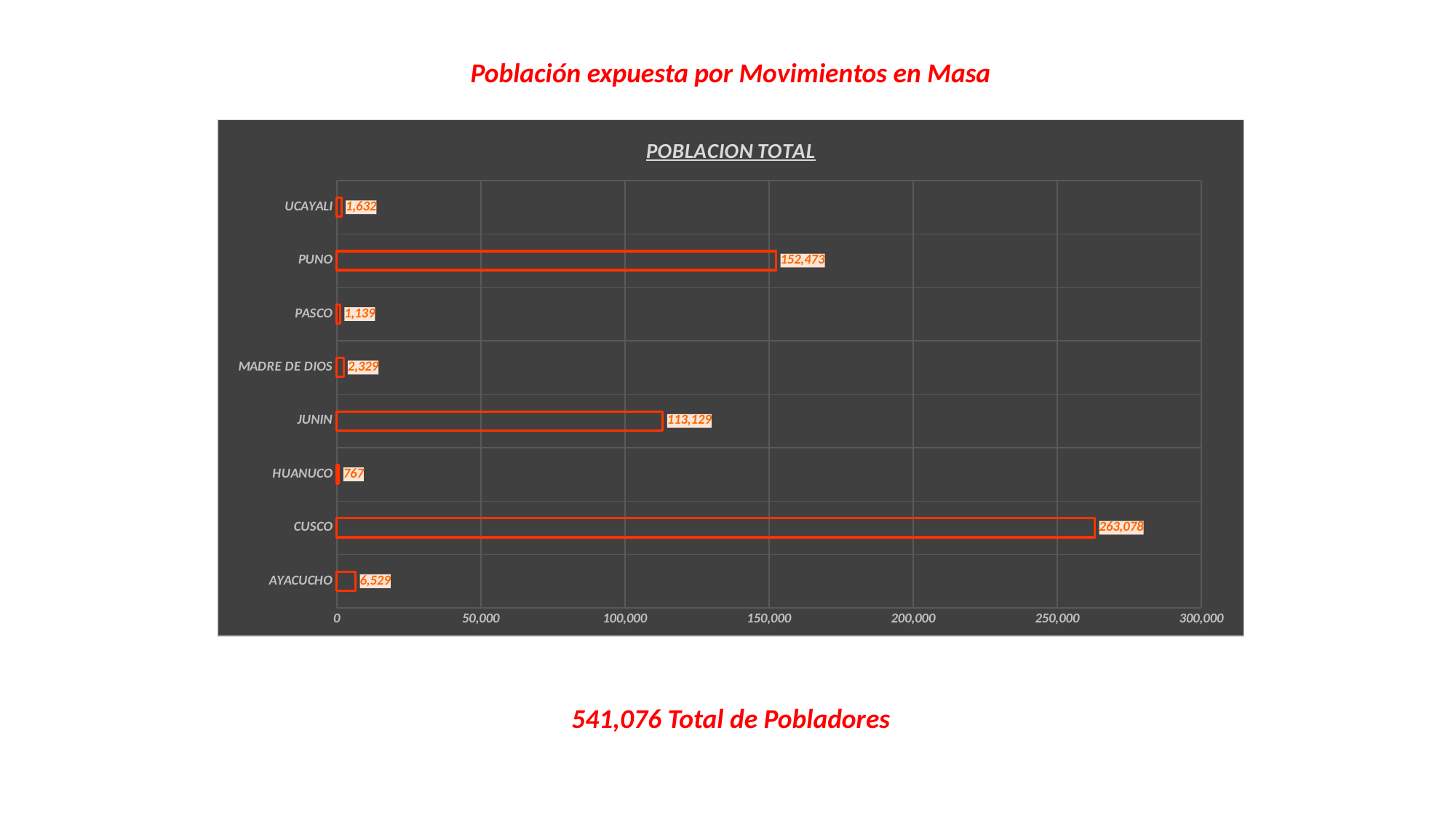
What kind of chart is shown on the slide? Bar chart What is the difference between the values for PUNO and JUNIN? 39,344 Which category has the lowest value in the POBLACION TOTAL chart? HUANUCO What is the value for JUNIN in the POBLACION TOTAL chart? 113,129 Is the value for PUNO greater or less than 150,000? greater What is the title of the chart on the slide? POBLACION TOTAL Which category has the highest value in the POBLACION TOTAL chart? CUSCO What is the difference between the values for CUSCO and PUNO? 110,605 What is the value for HUANUCO in the POBLACION TOTAL chart? 767 What is the value for CUSCO in the POBLACION TOTAL chart? 263,078 Which is larger, the value for AYACUCHO or the value for MADRE DE DIOS? AYACUCHO How many categories are shown in the POBLACION TOTAL chart? 8